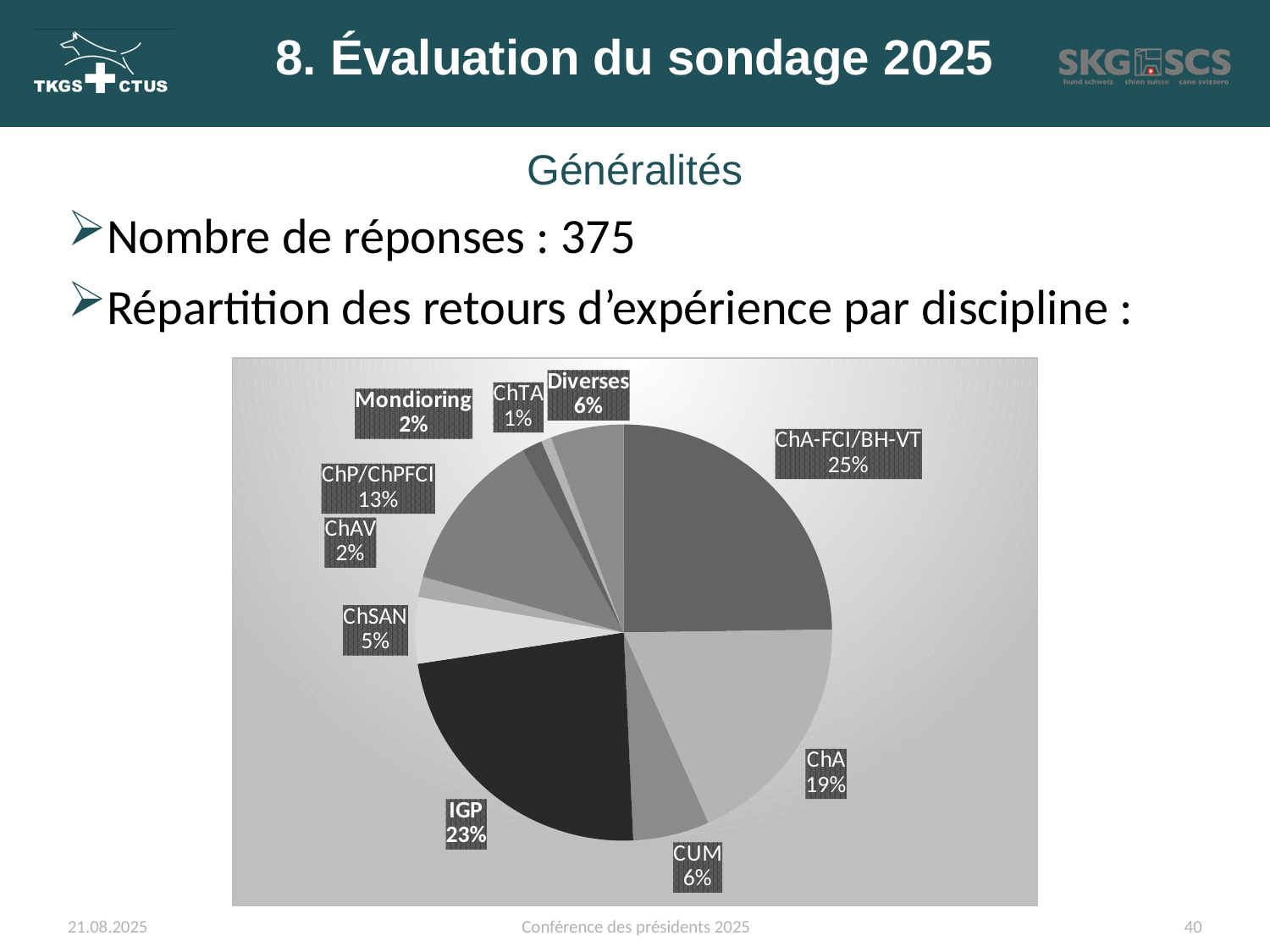
Which discipline has the largest share of the pie? ChA-FCI/BH-VT Which discipline has the smallest share of the pie? ChTA Which is larger, the share for IGP or the share for ChA? IGP What is the difference in percentage points between ChA-FCI/BH-VT and ChA? 6 What share of the pie does ChA-FCI/BH-VT represent? 25% What is the value shown for ChSAN? 5% How many slices does the pie chart have? 10 What is the difference in percentage points between ChP/ChPFCI and CUM? 7 What is the value shown for IGP? 23% What is the value shown for ChP/ChPFCI? 13% Which two disciplines both show a share of 6%? CUM and Diverses What kind of chart is shown on the slide? pie chart